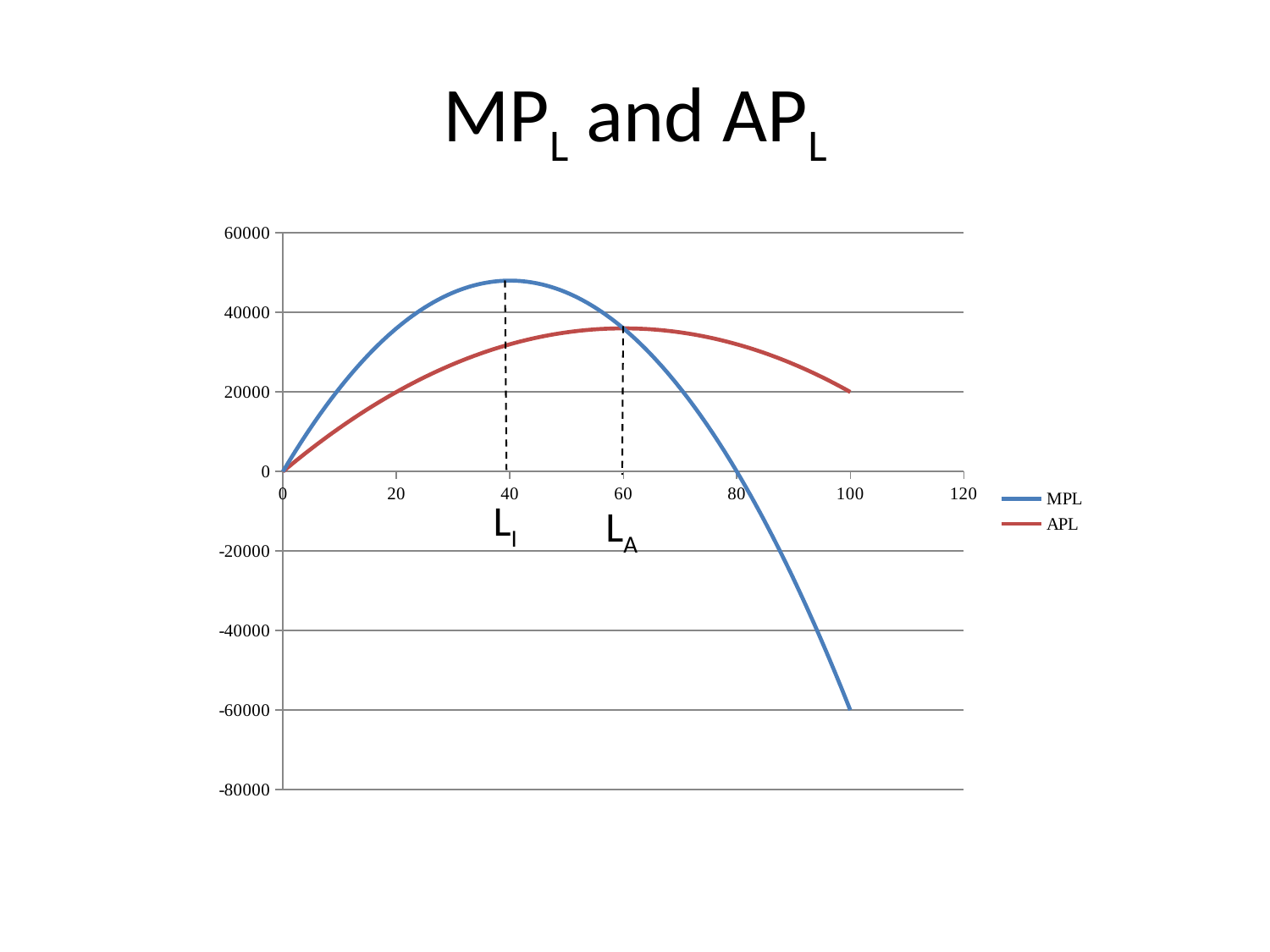
At what x value does the MPL curve cross zero on its way down? 80 What kind of chart is shown on the slide? line chart Is the value of APL at x = 60 greater or less than 40000? less What are the two series named in the legend? MPL and APL Is the value of MPL at x = 40 greater or less than 40000? greater Which series reaches the higher peak value? MPL What is the value of APL at x = 100? 20000 At x = 80, which series has the larger value, MPL or APL? APL At x = 20, which series has the larger value, MPL or APL? MPL How many series does the legend list? 2 What is the value of MPL at x = 100? -60000 Does the MPL curve rise or fall between x = 60 and x = 100? fall